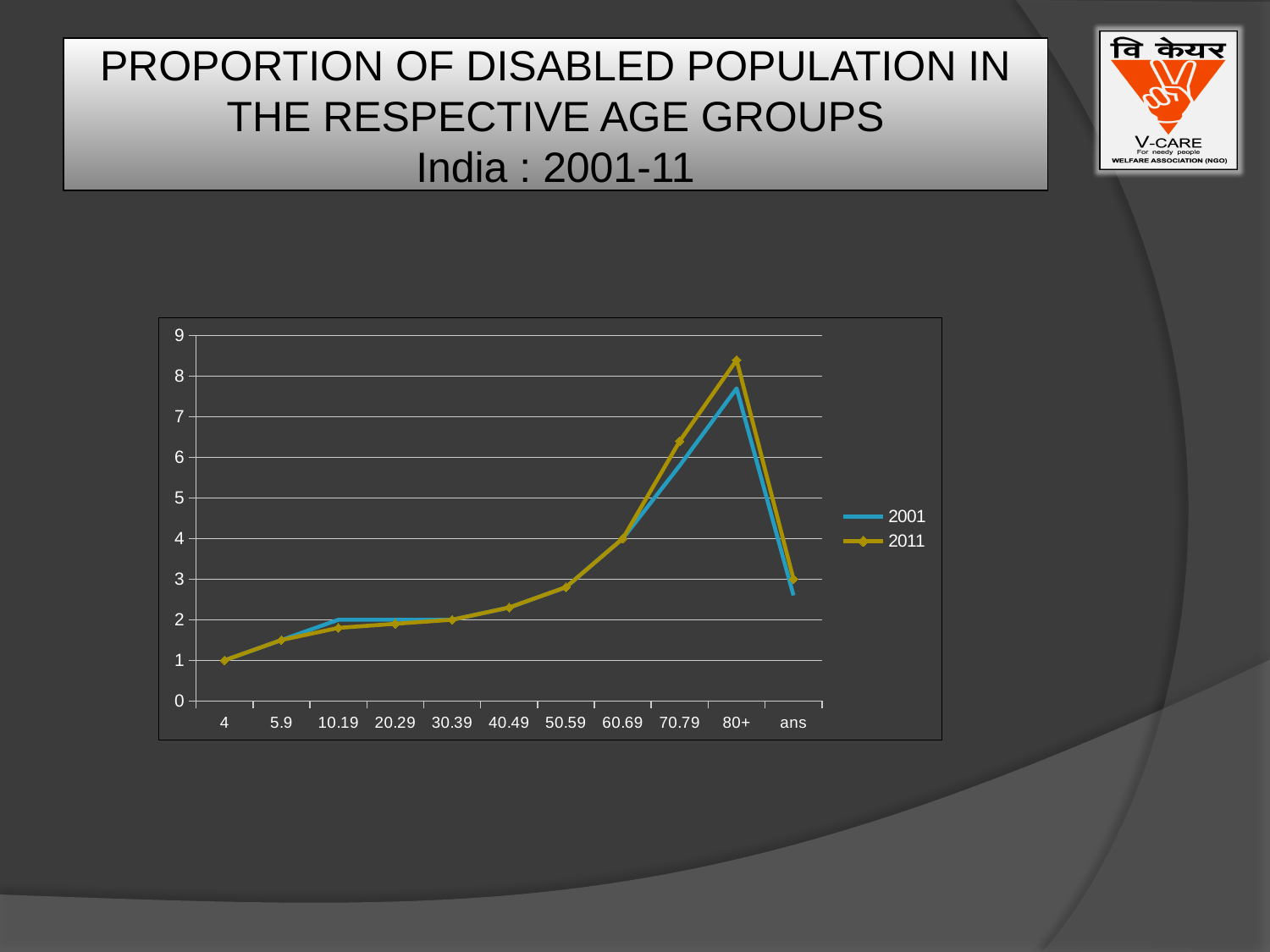
For the 80+ age group, which series has the larger value, 2001 or 2011? 2011 Which age group has the highest value for the 2001 series? 80+ How many series does the legend list? 2 Is the 2011 value for the 80+ age group greater or less than 8? greater Do the values rise or fall along the x axis from the 4 age group to the 80+ age group? rise How many age-group categories are shown on the x axis? 11 Which age group has the lowest value for the 2011 series? 4 Is the 2001 value for the 80+ age group greater or less than 8? less What are the two series named in the legend? 2001 and 2011 What kind of chart is shown on the slide? line chart Which age group has the highest value for the 2011 series? 80+ Is the 2011 value for the 70.79 age group greater or less than 6? greater